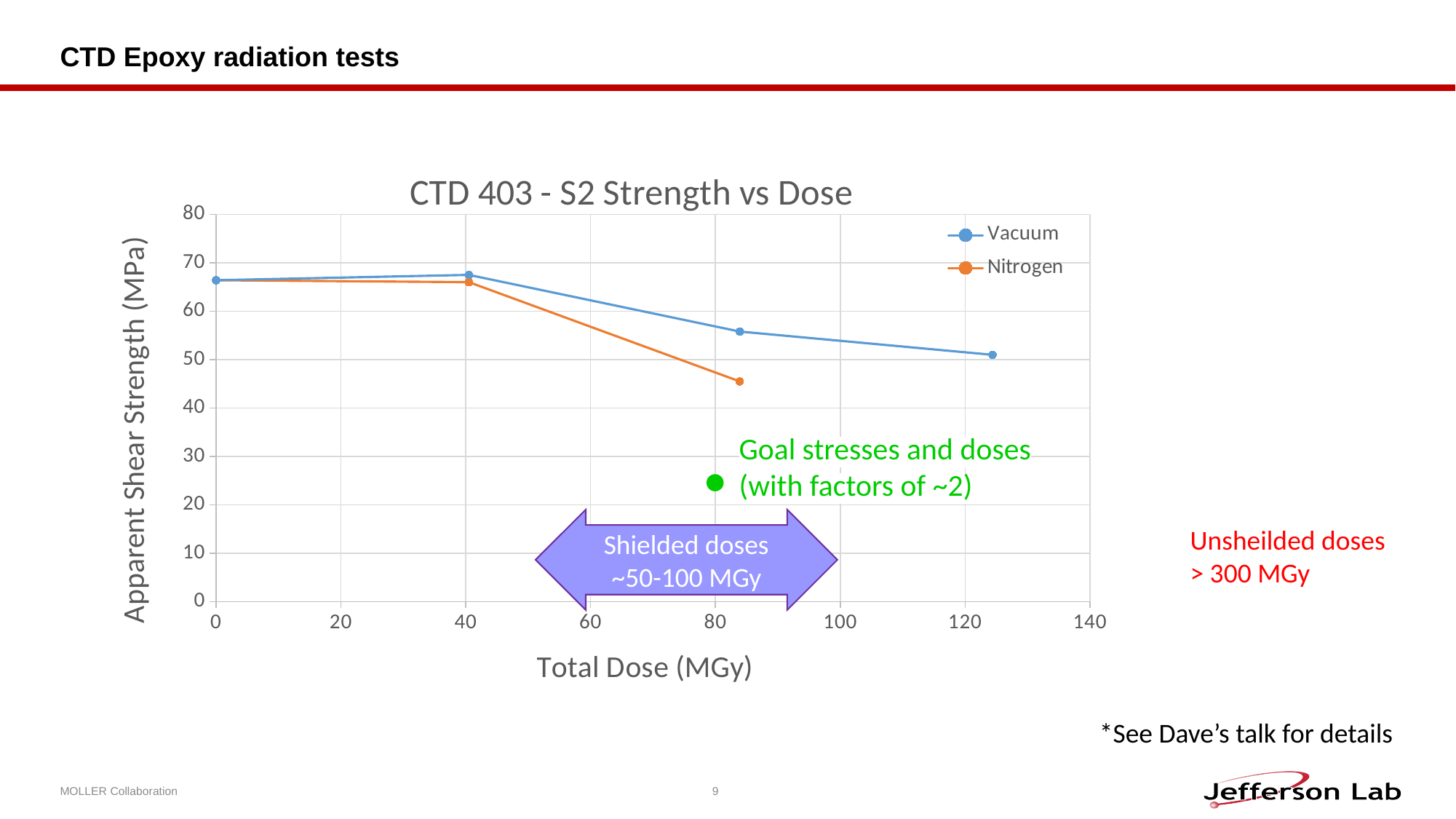
How many series does the chart legend list? 2 What kind of chart is shown on the slide? line chart Does the Nitrogen series rise or fall as total dose increases beyond 40 MGy? fall Is the Nitrogen value at a total dose of about 84 MGy greater or less than 50 MPa? less What are the two series named in the legend? Vacuum and Nitrogen How many data points are plotted for the Vacuum series? 4 How many data points are plotted for the Nitrogen series? 3 At a total dose of about 84 MGy, which series has the higher apparent shear strength, Vacuum or Nitrogen? Vacuum Is the Vacuum value at a total dose of 0 MGy greater or less than 60 MPa? greater Is the Vacuum value at a total dose of about 84 MGy greater or less than 60 MPa? less Does the Vacuum series rise or fall as total dose increases beyond 40 MGy? fall What is the title of the chart? CTD 403 - S2 Strength vs Dose